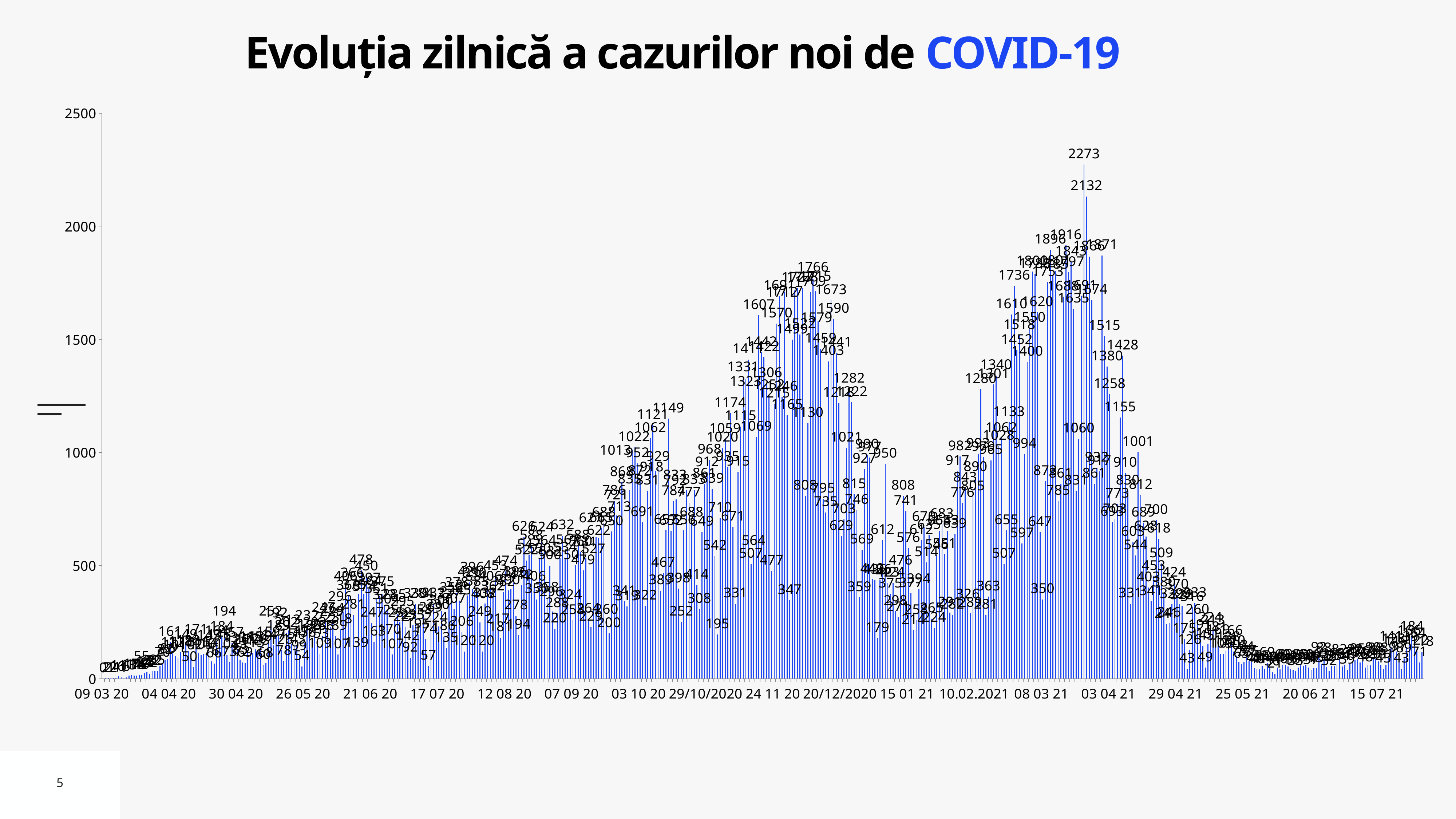
Is the highest bar on the chart greater or less than 2000? greater What is the title of the chart? Evoluția zilnică a cazurilor noi de COVID-19 What is the difference between the two highest labelled values, 2273 and 2132? 141 What is the difference between the peak of 2273 and the earlier peak of 1766? 507 What is the highest daily value labelled on the chart? 2273 What is the second-highest value labelled on the chart, next to the 2273 peak? 2132 What is the highest value labelled in the peak around 24 11 20? 1766 What is the maximum value shown on the vertical axis? 2500 What kind of chart is shown on the slide? bar chart How many date labels are shown along the x axis? 20 Which is larger: the peak value around 24 11 20 (1766) or the peak value around 03 04 21 (2273)? 2273 Do the values rise or fall between 03 04 21 and 25 05 21? fall